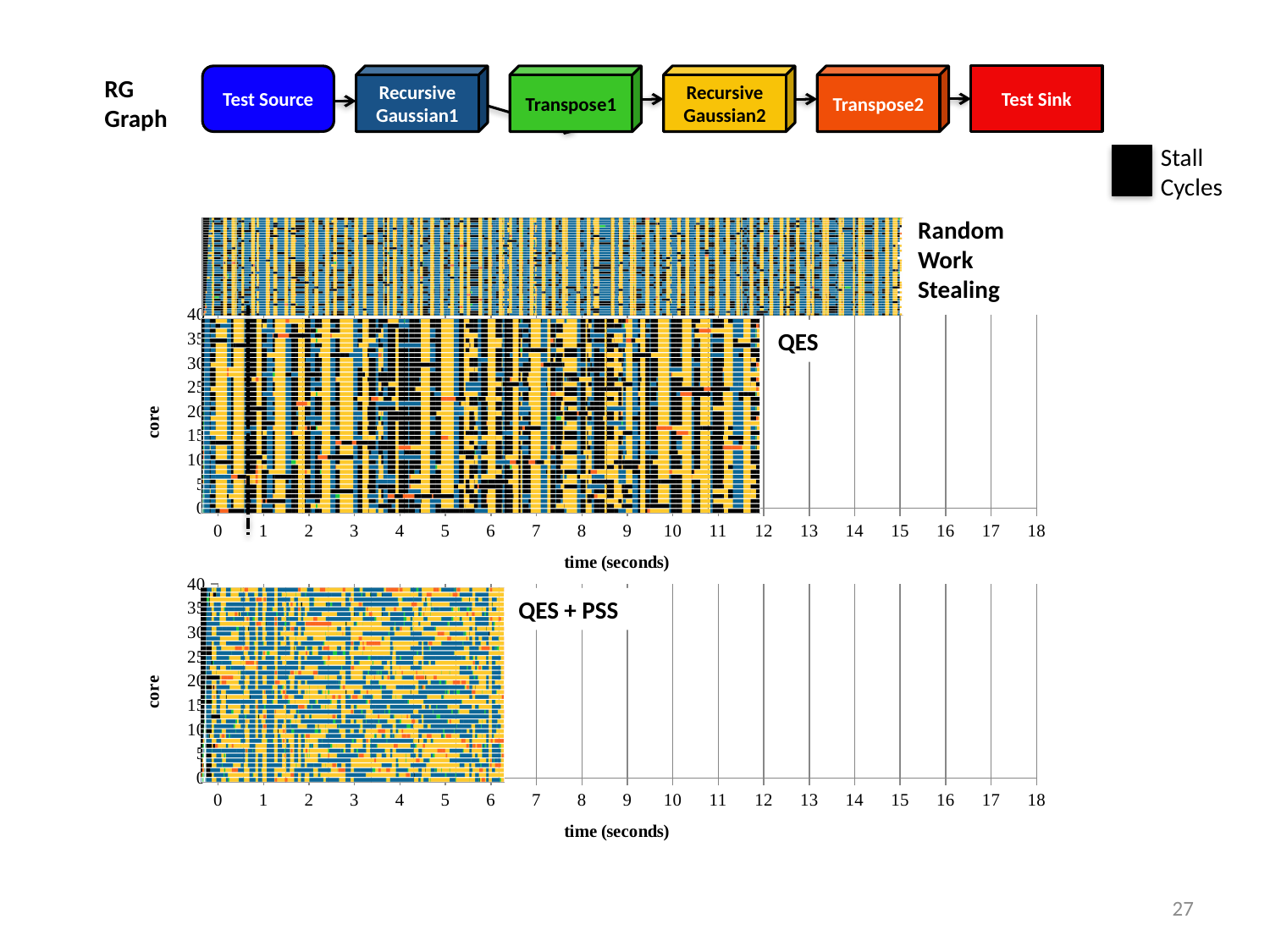
Which of the three schedules (Random Work Stealing, QES, QES + PSS) finishes in the shortest time? QES + PSS What is the highest value shown on the x axis of the QES + PSS chart? 18 What does the black colour represent according to the legend? Stall Cycles Which of the three schedules (Random Work Stealing, QES, QES + PSS) takes the longest time to finish? Random Work Stealing Does the QES + PSS run finish before or after 7 seconds? before What is the highest value shown on the y axis of the QES chart? 40 Does the Random Work Stealing run finish before or after 14 seconds? after What is the label on the x axis of the QES chart? time (seconds) What is the label on the y axis of the QES + PSS chart? core Which finishes earlier, the QES run or the Random Work Stealing run? QES How many stages are shown in the RG Graph pipeline at the top of the slide? 6 Does the QES run finish before or after 13 seconds? before